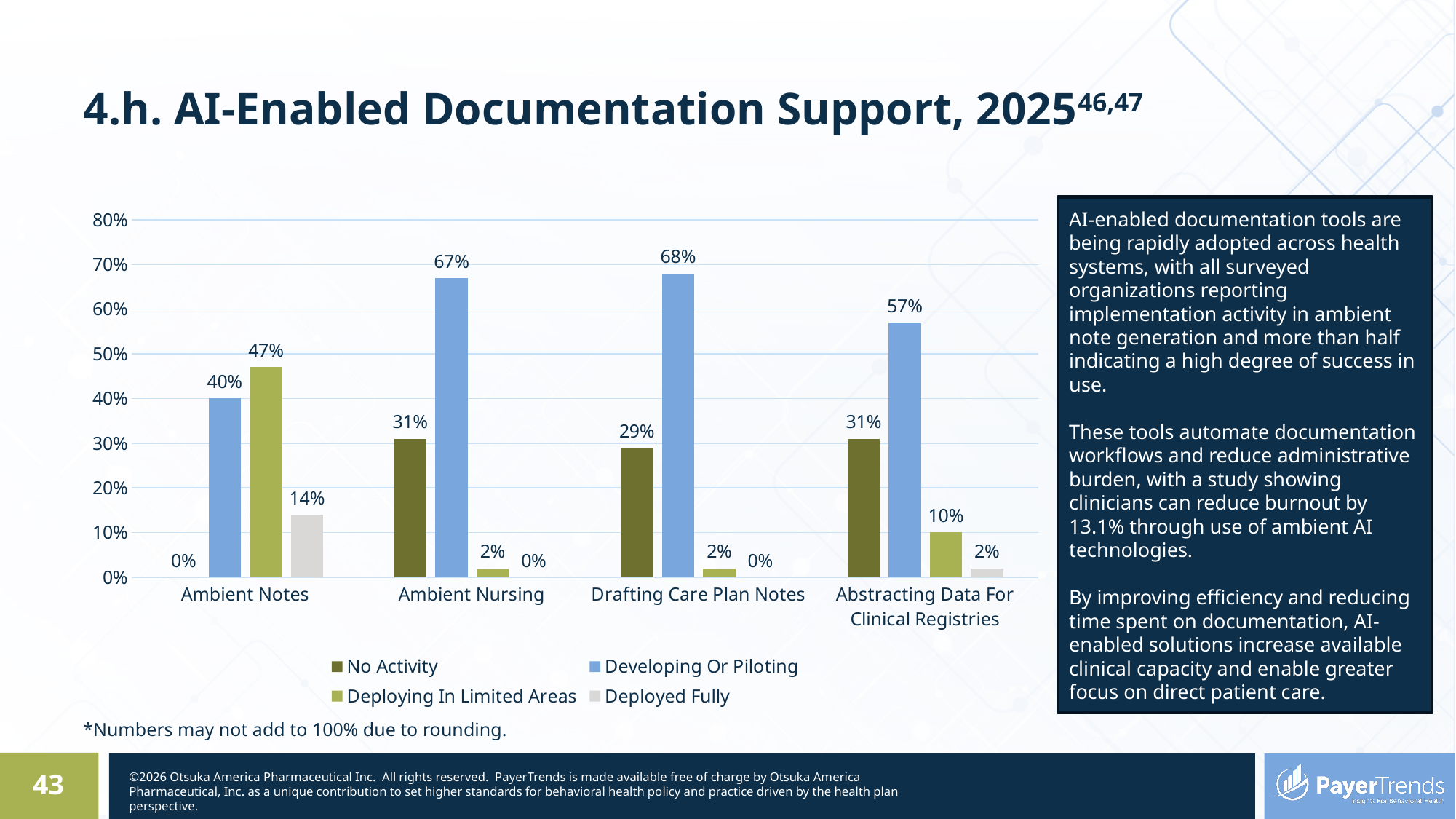
How many categories are shown on the x axis? 4 What is the title of the slide? 4.h. AI-Enabled Documentation Support, 2025 Which is larger: Deployed Fully for Ambient Notes or Deploying In Limited Areas for Abstracting Data For Clinical Registries? Deployed Fully for Ambient Notes What is the difference between the Developing Or Piloting values for Ambient Nursing and Abstracting Data For Clinical Registries? 10% Which category has the lowest value for No Activity? Ambient Notes What is the value for No Activity in the Drafting Care Plan Notes category? 29% What kind of chart is shown on the slide? Bar chart How many series does the legend list? 4 Which category has the highest value for Developing Or Piloting? Drafting Care Plan Notes What is the value for Deployed Fully in the Abstracting Data For Clinical Registries category? 2% What is the value for Deploying In Limited Areas in the Ambient Notes category? 47% What is the value for Developing Or Piloting in the Ambient Nursing category? 67%